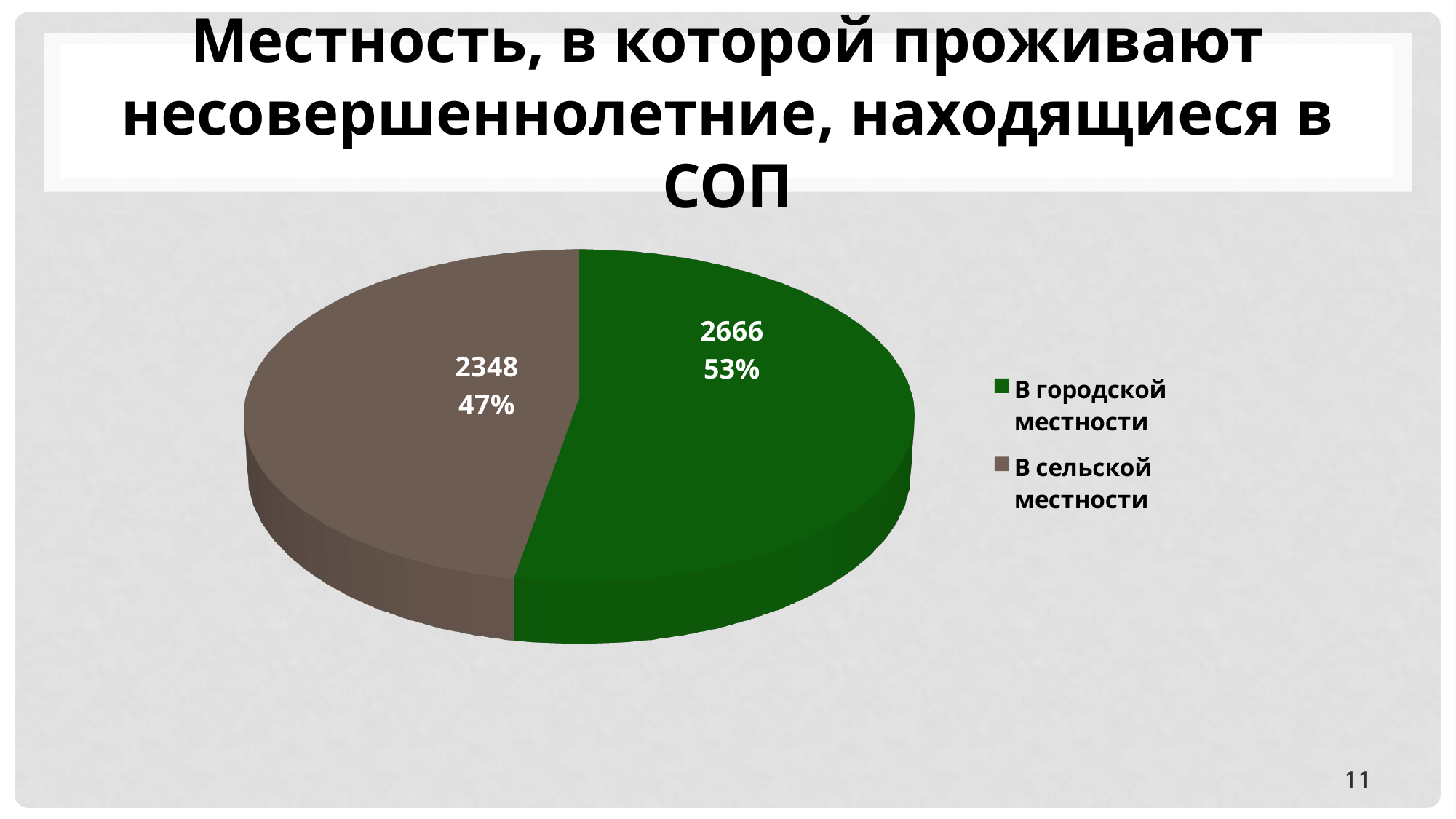
What kind of chart is shown on the slide? pie chart What is the value for "В сельской местности"? 2348 Which category has the smallest slice? В сельской местности What share of the pie does "В сельской местности" represent? 47% What share of the pie does "В городской местности" represent? 53% What is the difference between the values for "В городской местности" and "В сельской местности"? 318 How many slices does the pie chart have? 2 Which is larger: the value for "В городской местности" or "В сельской местности"? В городской местности Which category has the largest slice? В городской местности What is the total of the two slices in the pie chart? 5014 What colour is the slice for "В сельской местности"? brown What is the value for "В городской местности"? 2666